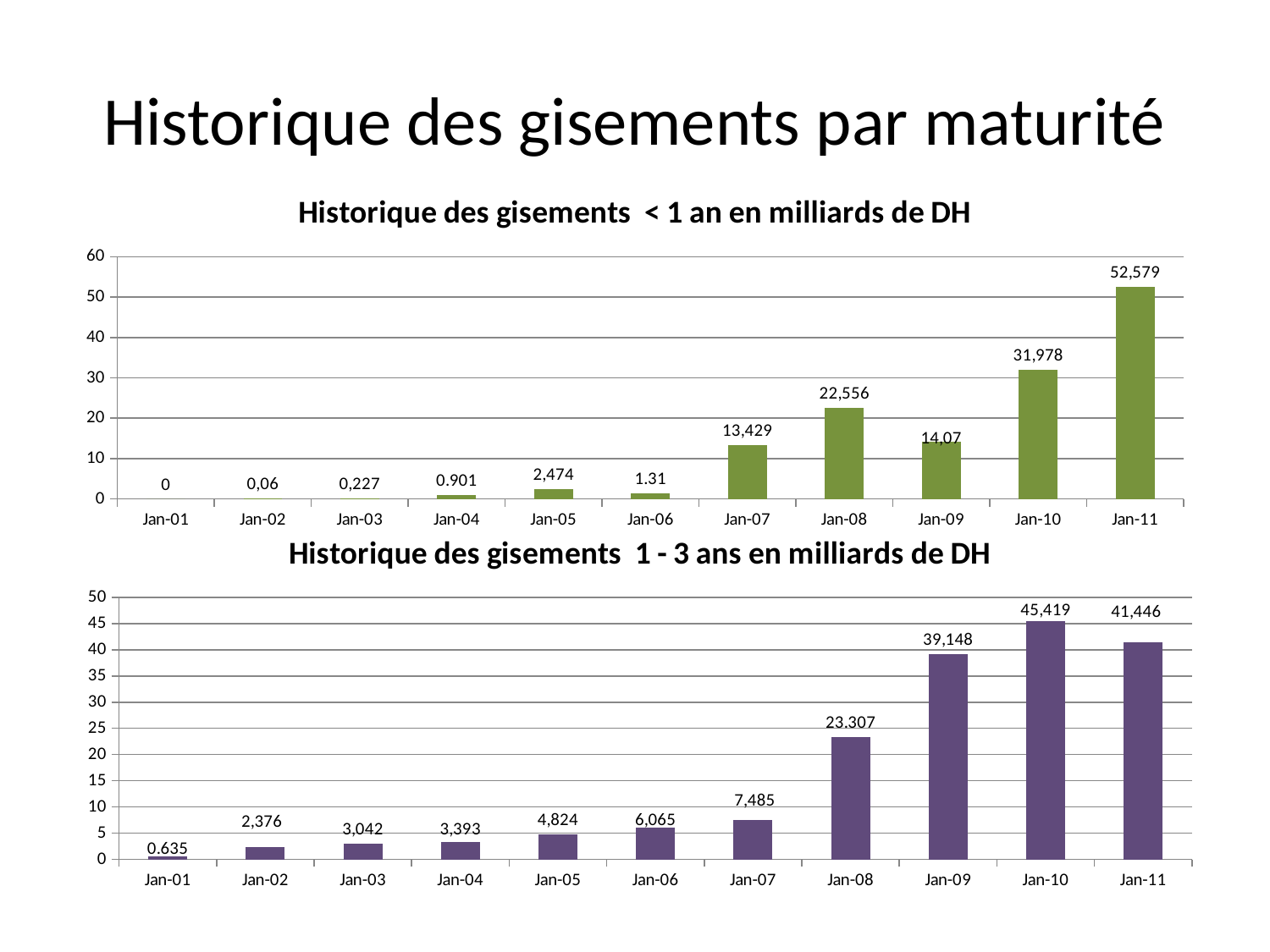
In the chart 'Historique des gisements < 1 an en milliards de DH', which category has the highest value? Jan-11 In the chart 'Historique des gisements 1 - 3 ans en milliards de DH', which category has the highest value? Jan-10 In the chart 'Historique des gisements < 1 an en milliards de DH', how many categories are shown on the x axis? 11 In the chart 'Historique des gisements 1 - 3 ans en milliards de DH', what is the difference between the values for Jan-10 and Jan-11? 3,973 In the chart 'Historique des gisements < 1 an en milliards de DH', what is the value for Jan-08? 22,556 In the chart 'Historique des gisements 1 - 3 ans en milliards de DH', do the values generally rise or fall from Jan-01 to Jan-10? Rise In the chart 'Historique des gisements 1 - 3 ans en milliards de DH', is the value for Jan-08 greater or less than 20? greater In the chart 'Historique des gisements < 1 an en milliards de DH', what is the difference between the values for Jan-11 and Jan-10? 20,601 In the chart 'Historique des gisements 1 - 3 ans en milliards de DH', what is the value for Jan-09? 39,148 In the chart 'Historique des gisements < 1 an en milliards de DH', which is larger, the value for Jan-08 or the value for Jan-09? Jan-08 In the chart 'Historique des gisements < 1 an en milliards de DH', which category has the lowest value? Jan-01 What kind of chart is the bottom chart on the slide? Bar chart